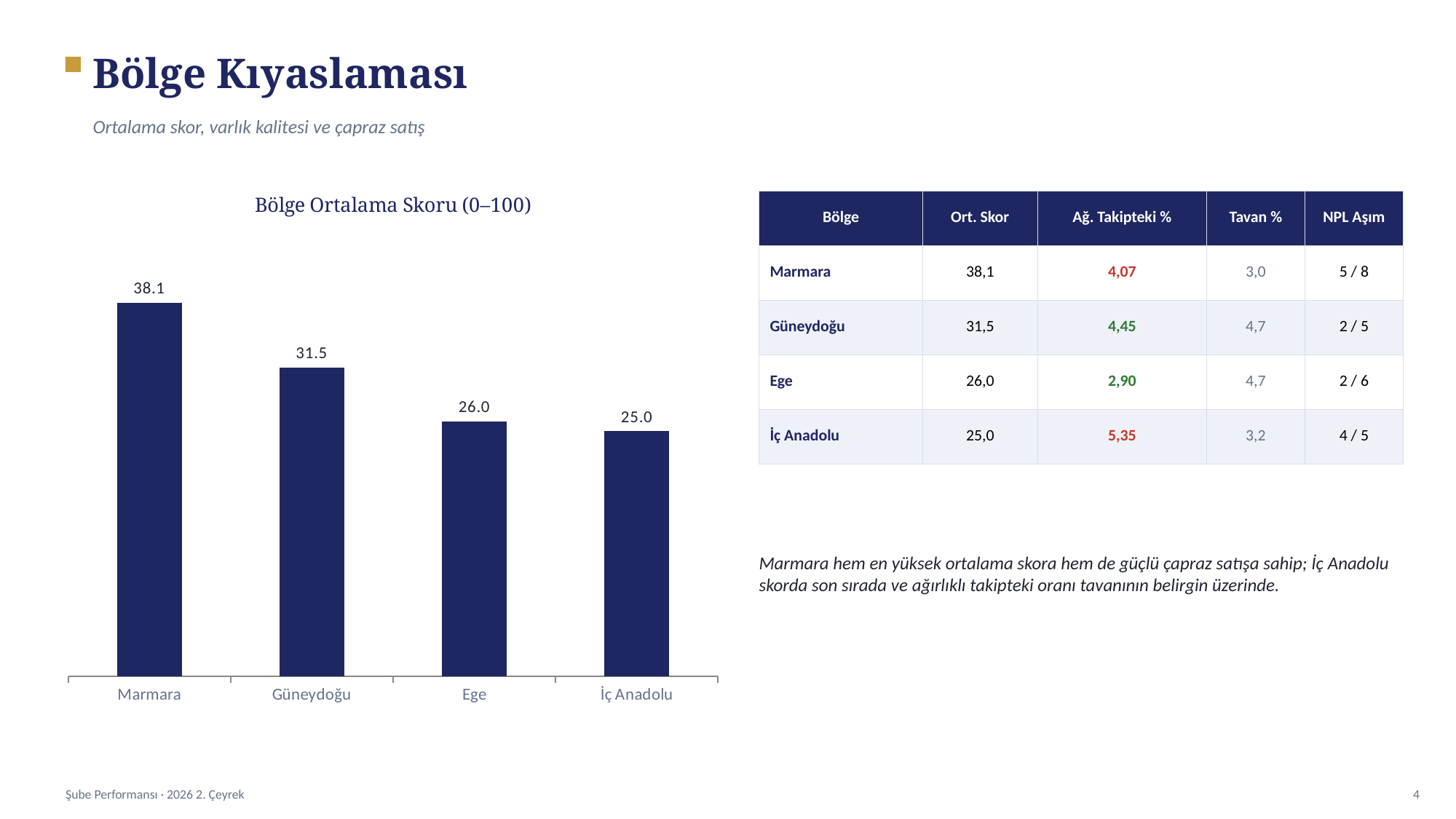
What is the value for Marmara in the chart? 38.1 What is the value for Ege in the chart? 26.0 Which is larger, the value for Güneydoğu or the value for Ege? Güneydoğu What is the difference between the values for Marmara and Güneydoğu? 6.6 How many regions are shown in the chart? 4 What is the value for Güneydoğu in the chart? 31.5 What is the value for İç Anadolu in the chart? 25.0 What is the title of the chart? Bölge Ortalama Skoru (0–100) What is the difference between the values for Ege and İç Anadolu? 1.0 Which region has the lowest average score in the chart? İç Anadolu What kind of chart is shown on the slide? Bar chart Which region has the highest average score in the chart? Marmara